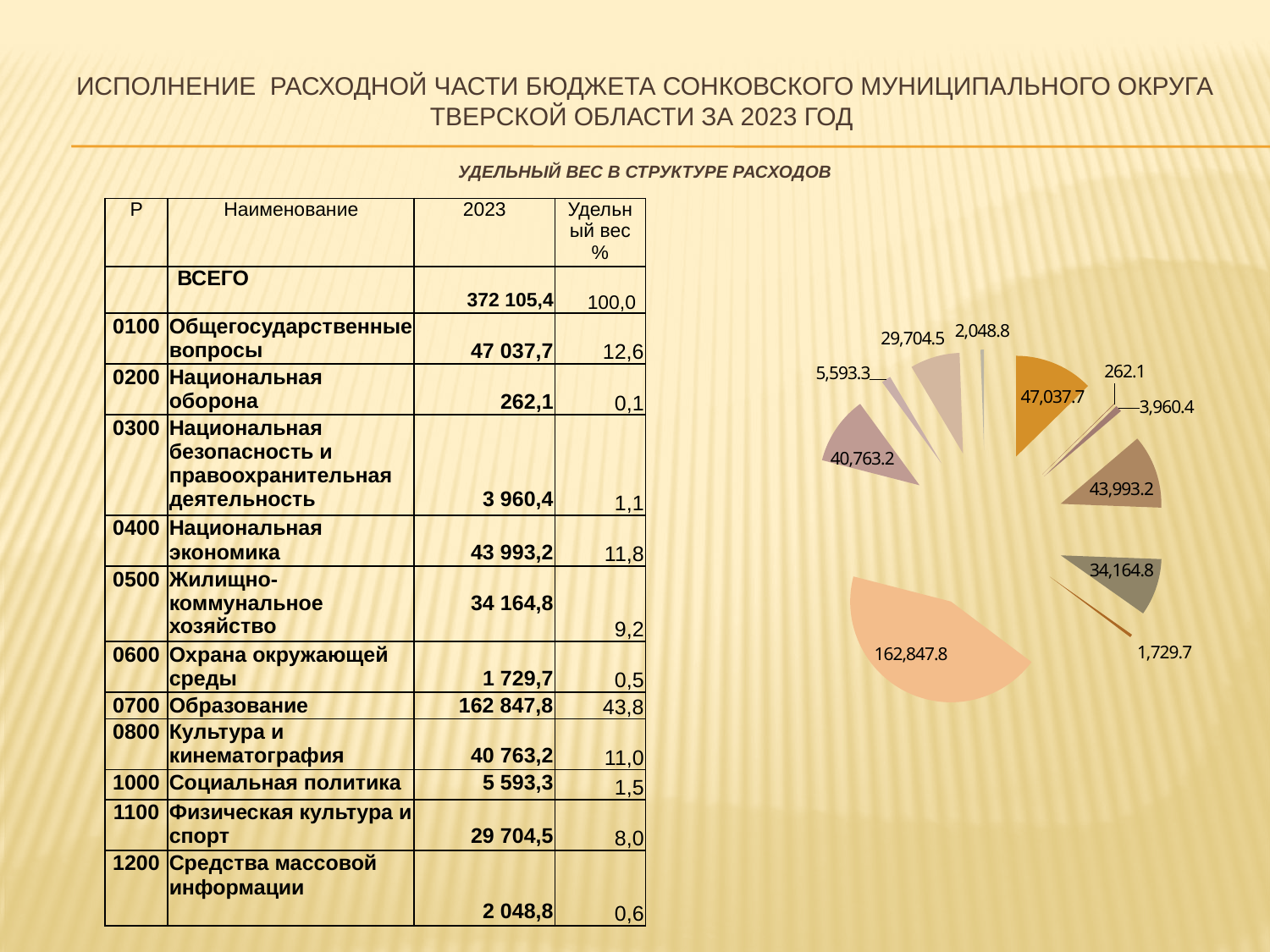
According to the table, which expenditure category does the pie slice labelled 47,037.7 correspond to? Общегосударственные вопросы What is the value of the largest slice in the pie chart? 162,847.8 What kind of chart is shown on the right side of the slide? pie chart Does the pie chart include a legend? No What is the heading printed above the table and pie chart? УДЕЛЬНЫЙ ВЕС В СТРУКТУРЕ РАСХОДОВ What is the value of the smallest slice in the pie chart? 262.1 According to the table on the slide, what share of total expenditure does the largest pie slice (162,847.8, Образование) represent? 43,8 What is the difference between the slices labelled 5,593.3 and 3,960.4 in the pie chart? 1,632.9 What is the difference between the slices labelled 47,037.7 and 43,993.2 in the pie chart? 3,044.5 What is the difference between the slices labelled 34,164.8 and 29,704.5 in the pie chart? 4,460.3 How many slices does the pie chart have? 11 In the pie chart, which slice is larger: the one labelled 40,763.2 or the one labelled 34,164.8? 40,763.2